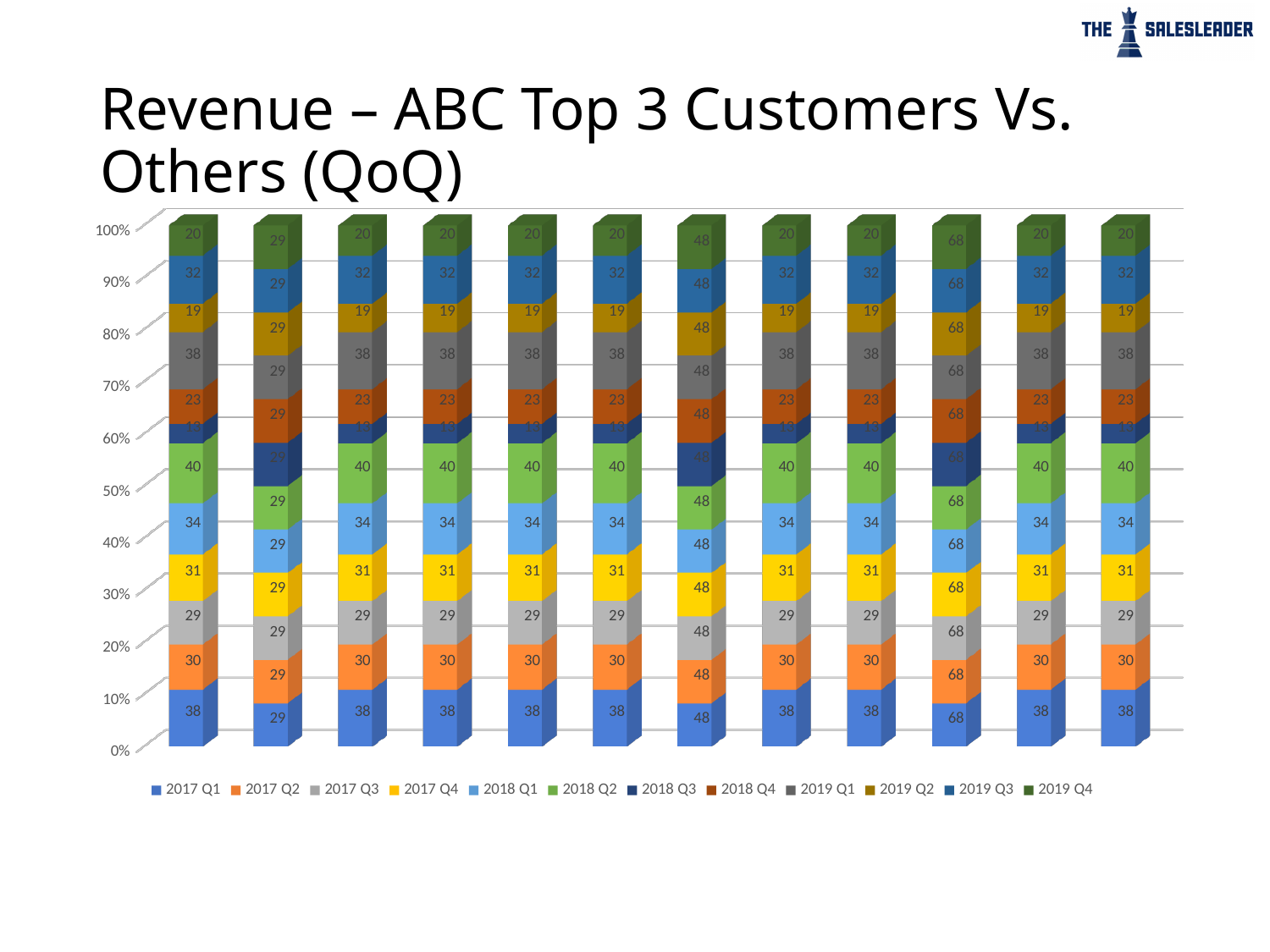
In the first (leftmost) bar, which series has the smallest labelled value? 2018 Q3 In the first (leftmost) bar, what is the difference between the 2018 Q2 value and the 2018 Q3 value? 27 In the tenth bar from the left, what is the value labelled on the 2017 Q4 segment? 68 How many series does the legend list? 12 In the first (leftmost) bar, what is the value labelled on the 2018 Q2 segment? 40 What kind of chart is shown on the slide? Stacked bar chart In the seventh bar from the left, what is the value labelled on the 2019 Q4 segment? 48 In the second bar from the left, what is the value labelled on the 2017 Q3 segment? 29 In the first (leftmost) bar, what is the value labelled on the 2017 Q1 segment? 38 What is the title of the chart on the slide? Revenue – ABC Top 3 Customers Vs. Others (QoQ) In the first (leftmost) bar, which series has the largest labelled value? 2018 Q2 How many stacked bars are plotted in the chart? 12